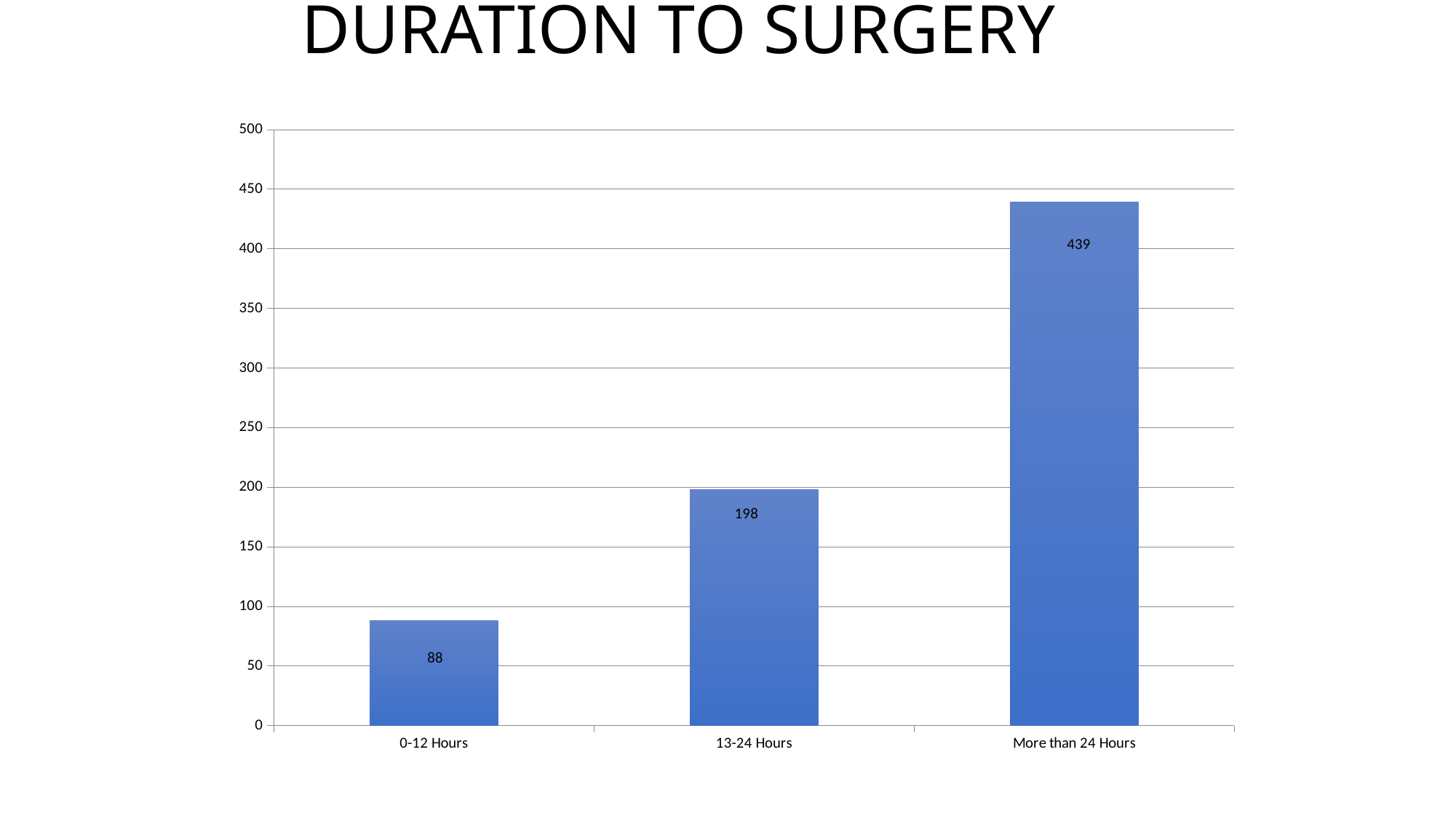
Is the value for More than 24 Hours greater or less than 400? greater What is the value for More than 24 Hours? 439 Which category has the highest value? More than 24 Hours Which category has the lowest value? 0-12 Hours What is the difference between the values for 13-24 Hours and 0-12 Hours? 110 What is the value for 13-24 Hours? 198 What is the value for 0-12 Hours? 88 What kind of chart is shown on the slide? bar chart Which is larger, the value for 13-24 Hours or the value for 0-12 Hours? 13-24 Hours What is the difference between the values for More than 24 Hours and 13-24 Hours? 241 How many categories are shown on the x axis? 3 Do the values rise or fall from left to right along the x axis? rise